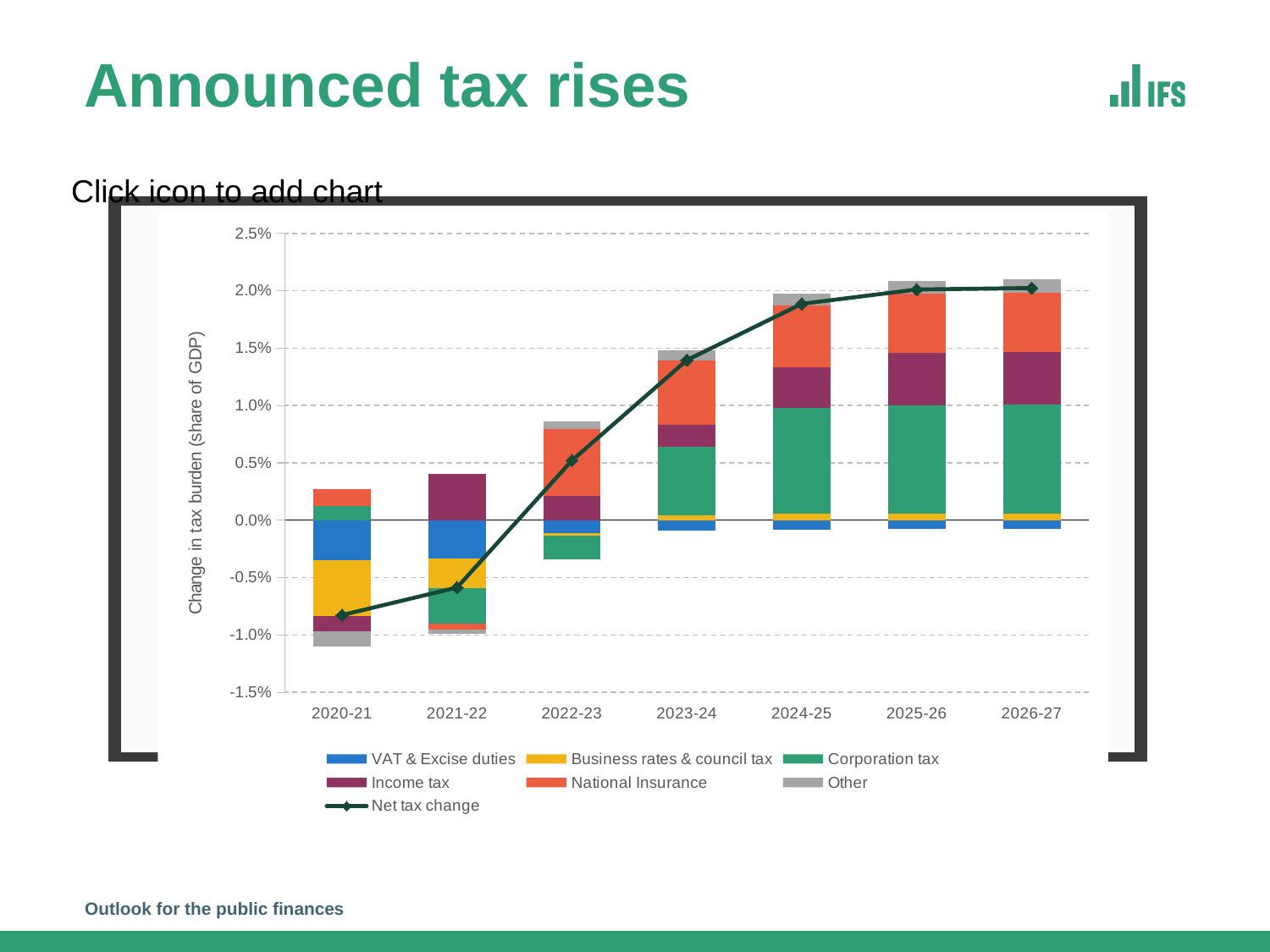
Is the net tax change for 2020-21 greater or less than -0.5%? less Is the net tax change for 2023-24 greater or less than 1.0%? greater What kind of chart is shown on the slide? Stacked bar chart with a line Does the net tax change rise or fall from 2020-21 to 2026-27? Rises How many years (categories) are shown on the x axis? 7 How many series does the legend list? 7 Is the net tax change for 2021-22 greater or less than 0.0%? less Which year has the lowest net tax change? 2020-21 What is the label on the vertical axis? Change in tax burden (share of GDP) Which legend entry is shown as a line with markers rather than a bar? Net tax change Which is larger, the net tax change in 2021-22 or in 2022-23? 2022-23